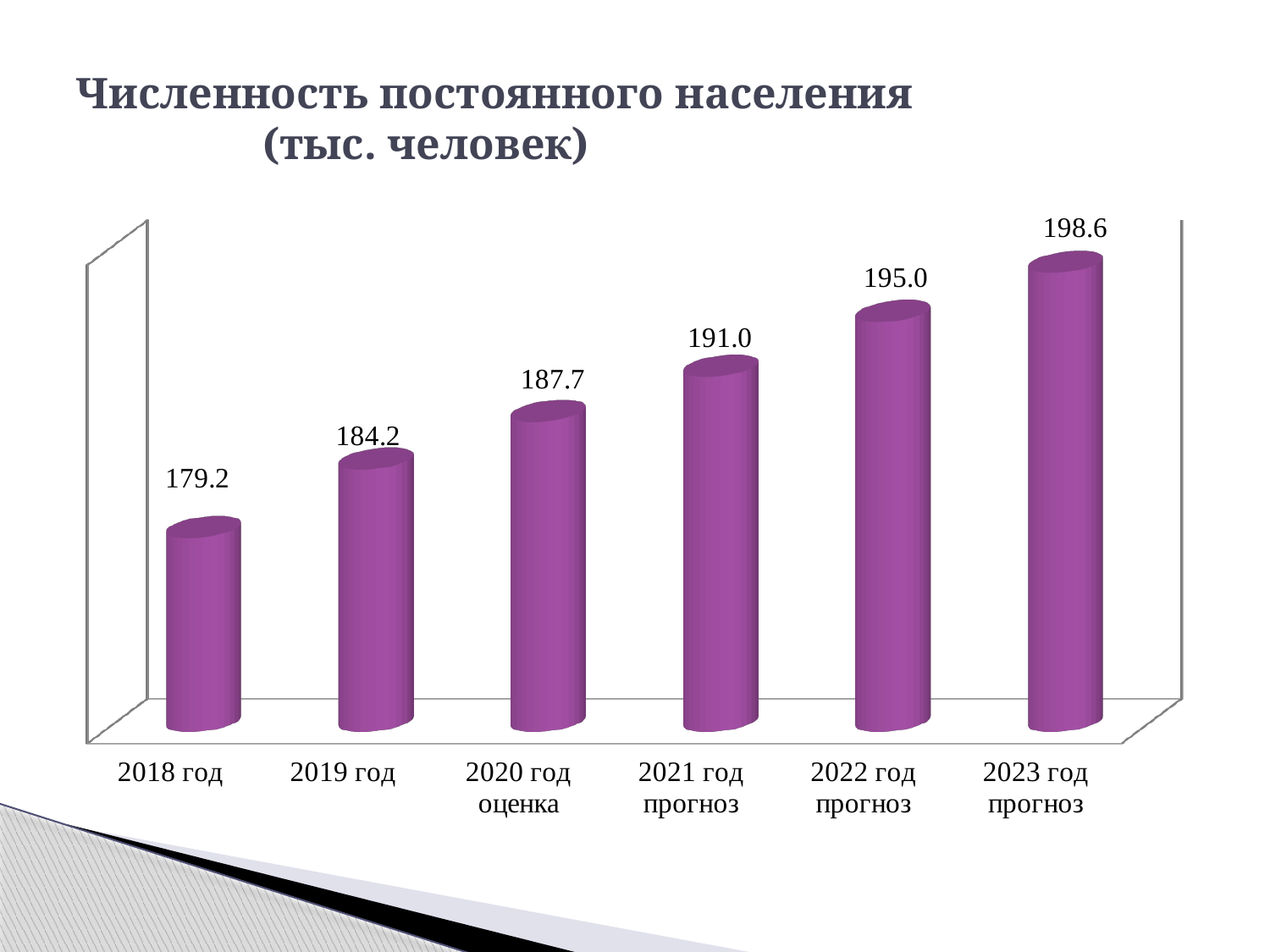
Which category has the lowest value? 2018 год What is the title of the chart? Численность постоянного населения (тыс. человек) What is the value for 2020 год оценка? 187.7 Which category has the highest value? 2023 год прогноз What is the difference between the values for 2023 год прогноз and 2018 год? 19.4 What is the value for 2022 год прогноз? 195.0 What kind of chart is this? bar chart What is the difference between the values for 2021 год прогноз and 2019 год? 6.8 What is the value for 2018 год? 179.2 How many categories are shown on the chart? 6 Do the values rise or fall from 2018 год to 2023 год прогноз? rise Which is larger, the value for 2019 год or the value for 2021 год прогноз? 2021 год прогноз